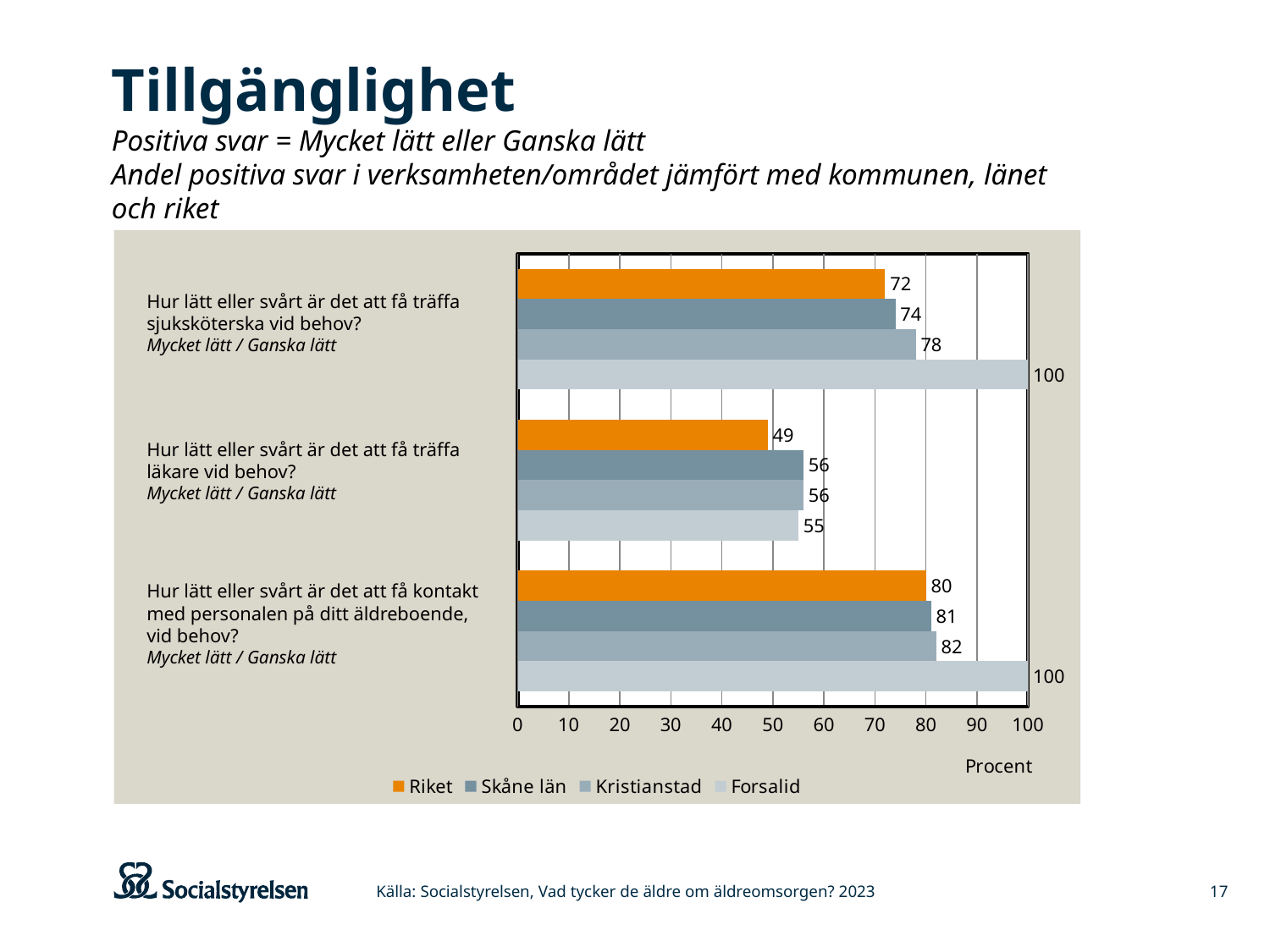
How many question categories are plotted on the chart? 3 How many series does the legend list? 4 For 'Hur lätt eller svårt är det att få träffa läkare vid behov?', which is larger: the value for Skåne län or the value for Riket? Skåne län Which series has the highest value for 'Hur lätt eller svårt är det att få kontakt med personalen på ditt äldreboende, vid behov?'? Forsalid What is the value for Skåne län for 'Hur lätt eller svårt är det att få träffa sjuksköterska vid behov?'? 74 What is the value for Riket for 'Hur lätt eller svårt är det att få träffa läkare vid behov?'? 49 What label is shown on the horizontal axis of the chart? Procent What is the value for Forsalid for 'Hur lätt eller svårt är det att få träffa sjuksköterska vid behov?'? 100 What is the difference between the Forsalid value and the Riket value for 'Hur lätt eller svårt är det att få träffa sjuksköterska vid behov?'? 28 What is the value for Kristianstad for 'Hur lätt eller svårt är det att få kontakt med personalen på ditt äldreboende, vid behov?'? 82 What kind of chart is shown on the slide? Bar chart Which series has the lowest value for 'Hur lätt eller svårt är det att få träffa läkare vid behov?'? Riket